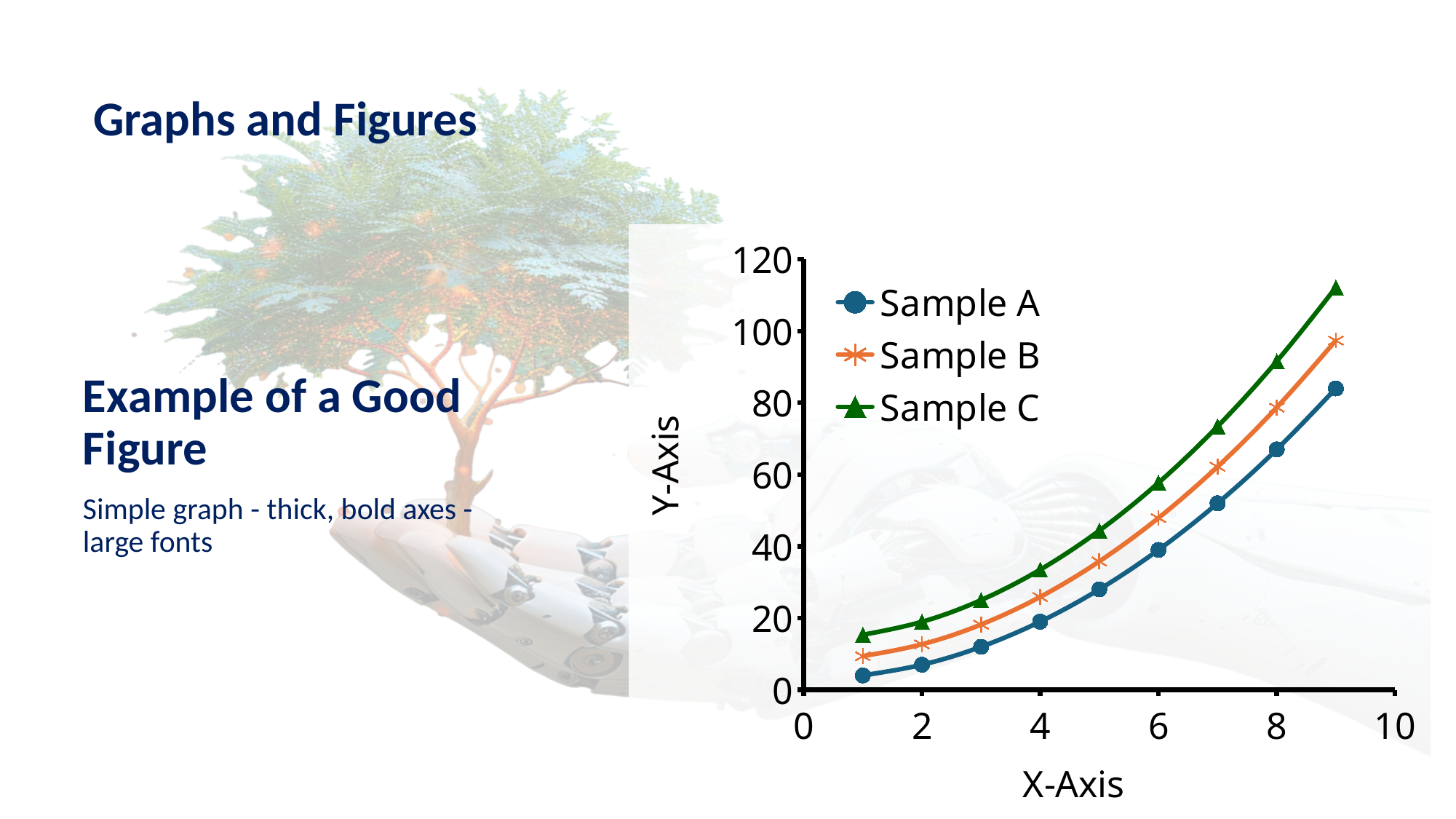
How many series does the legend list? 3 Which series are listed in the legend? Sample A, Sample B, Sample C At x = 7, is the value for Sample C greater or less than 60? greater At x = 1, is the value for Sample A greater or less than 20? less At x = 9, which is larger, the value for Sample C or the value for Sample A? Sample C How many data points are plotted for Sample A? 9 At x = 9, is the value for Sample C greater or less than 100? greater Do the values for Sample C rise or fall as the x axis increases? rise Which series has the lowest value at x = 9? Sample A What is the title of the vertical axis? Y-Axis What kind of chart is shown on the slide? line chart Which series has the highest value at x = 9? Sample C